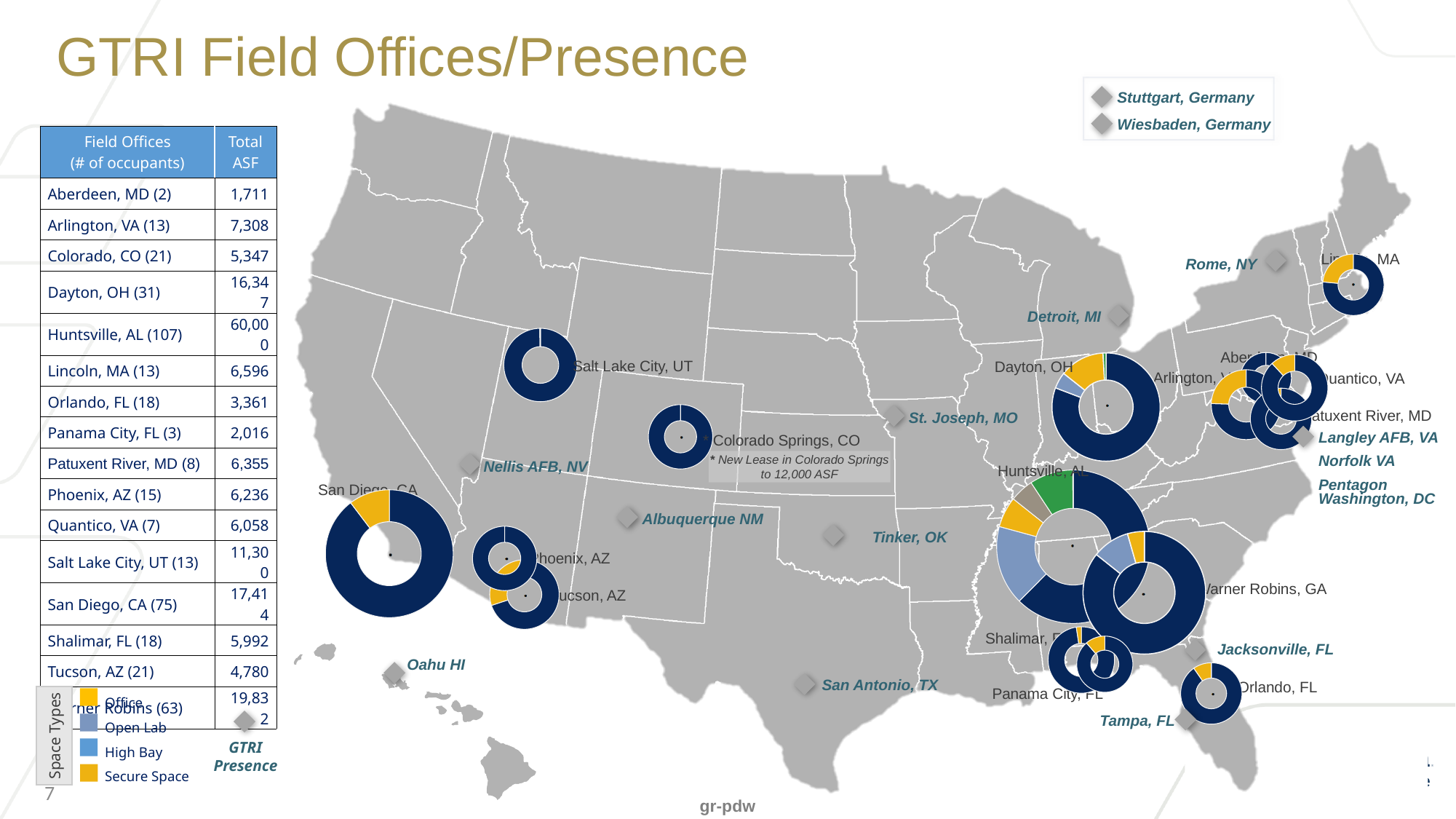
How many field offices are listed in the table? 16 What is the title of the legend in the lower left of the slide? Space Types How many space types does the Space Types legend list? 4 Which field office has the largest donut chart on the map? Huntsville, AL According to the table, which field office has the lowest Total ASF? Aberdeen, MD What kind of chart is used to show the space types at each field office on the map? donut (pie) chart According to the table, what is the difference in Total ASF between Arlington, VA and Quantico, VA? 1,250 According to the table, which has a larger Total ASF: Lincoln, MA or Patuxent River, MD? Lincoln, MA According to the note on the map, what ASF is the new lease in Colorado Springs? 12,000 ASF According to the table, what is the Total ASF for Huntsville, AL? 60,000 According to the table, which field office has the highest Total ASF? Huntsville, AL According to the table, what is the Total ASF for Dayton, OH? 16,347